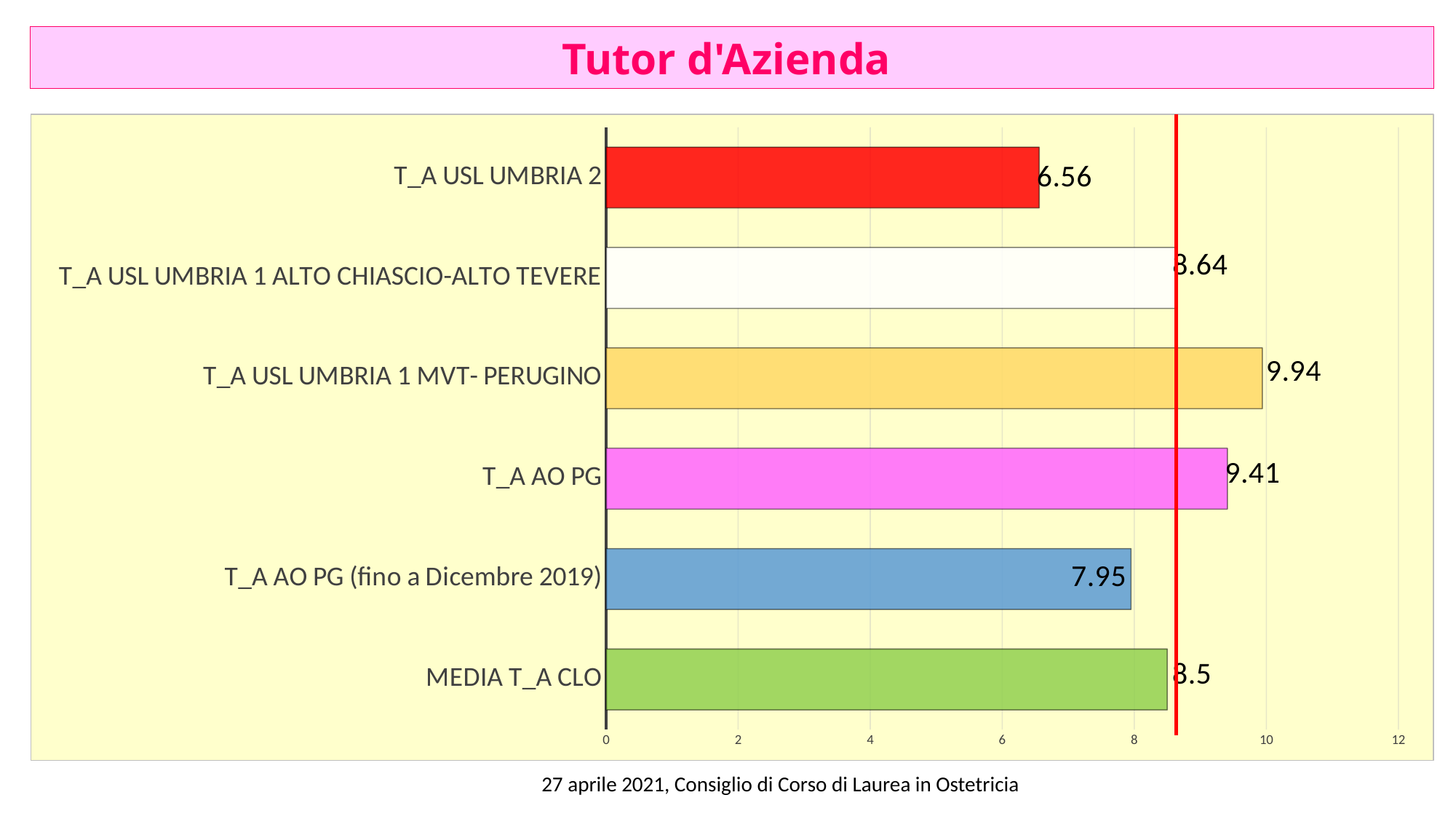
What kind of chart is shown on the slide? bar chart Is the value for T_A USL UMBRIA 1 ALTO CHIASCIO-ALTO TEVERE greater or less than 8? greater What is the difference between the values for T_A AO PG (fino a Dicembre 2019) and T_A USL UMBRIA 2? 1.39 How many categories are shown in the chart? 6 What is the value for T_A USL UMBRIA 2? 6.56 What is the value for T_A USL UMBRIA 1 MVT- PERUGINO? 9.94 Which category has the highest value? T_A USL UMBRIA 1 MVT- PERUGINO What is the value for T_A AO PG? 9.41 Which category has the lowest value? T_A USL UMBRIA 2 What is the value for T_A AO PG (fino a Dicembre 2019)? 7.95 What is the difference between the values for T_A USL UMBRIA 1 MVT- PERUGINO and T_A AO PG? 0.53 Which is larger, the value for T_A AO PG or the value for T_A AO PG (fino a Dicembre 2019)? T_A AO PG